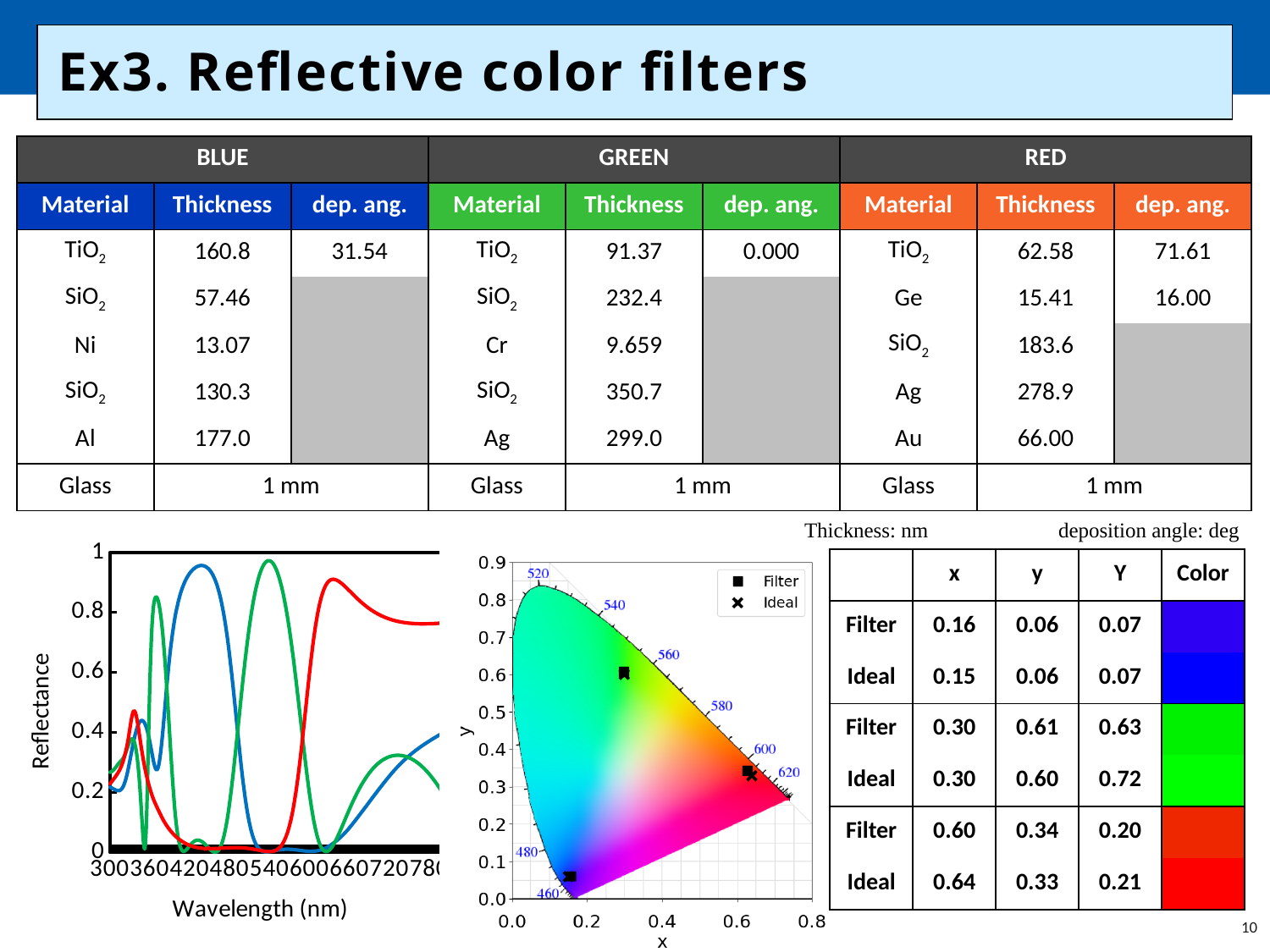
On the Reflectance chart, is the red line's value at 780 nm greater or less than 0.6? greater On the Reflectance chart, is the red line's value at 420 nm greater or less than 0.2? less How many lines are plotted on the Reflectance vs Wavelength chart? 3 On the Reflectance chart, which line reaches the highest reflectance between 420 and 480 nm, the blue line or the red line? blue line What is the x-axis label of the Reflectance chart on the left? Wavelength (nm) On the chromaticity diagram, is the y value of the Filter point near the 460 nm edge greater or less than 0.2? less What are the two legend entries on the chromaticity diagram on the right? Filter and Ideal How many series does the legend of the chromaticity diagram on the right list? 2 What kind of chart is the Reflectance vs Wavelength chart on the left? line chart